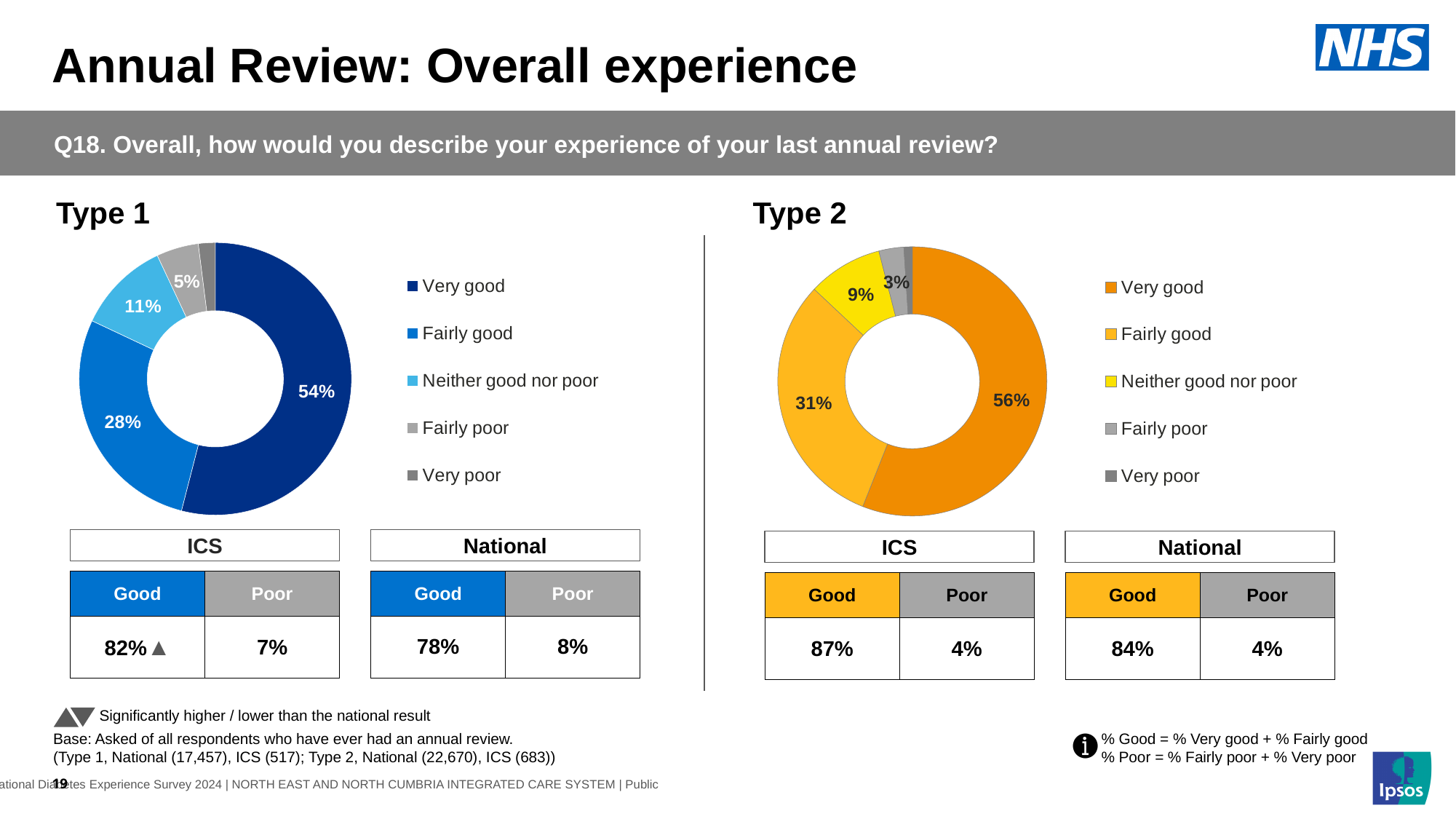
In the Type 1 chart, which response category has the largest share? Very good In the Type 2 chart, what percentage of respondents said Neither good nor poor? 9% In the Type 2 chart, which response category has the smallest share? Very poor In the Type 1 chart, what percentage of respondents said their experience was Very good? 54% In the Type 2 chart, what percentage of respondents said their experience was Very good? 56% Is the Very good share larger in the Type 1 chart or the Type 2 chart? Type 2 In the Type 1 chart, what percentage of respondents said their experience was Fairly good? 28% In the Type 2 chart, what percentage of respondents said Fairly poor? 3% In the Type 1 chart, what is the difference between the Very good and Fairly good shares? 26 percentage points In the Type 2 chart, what colour represents Neither good nor poor? Yellow How many response categories does the legend of the Type 1 chart list? 5 What kind of chart is used to show the Type 2 results? Doughnut (pie) chart